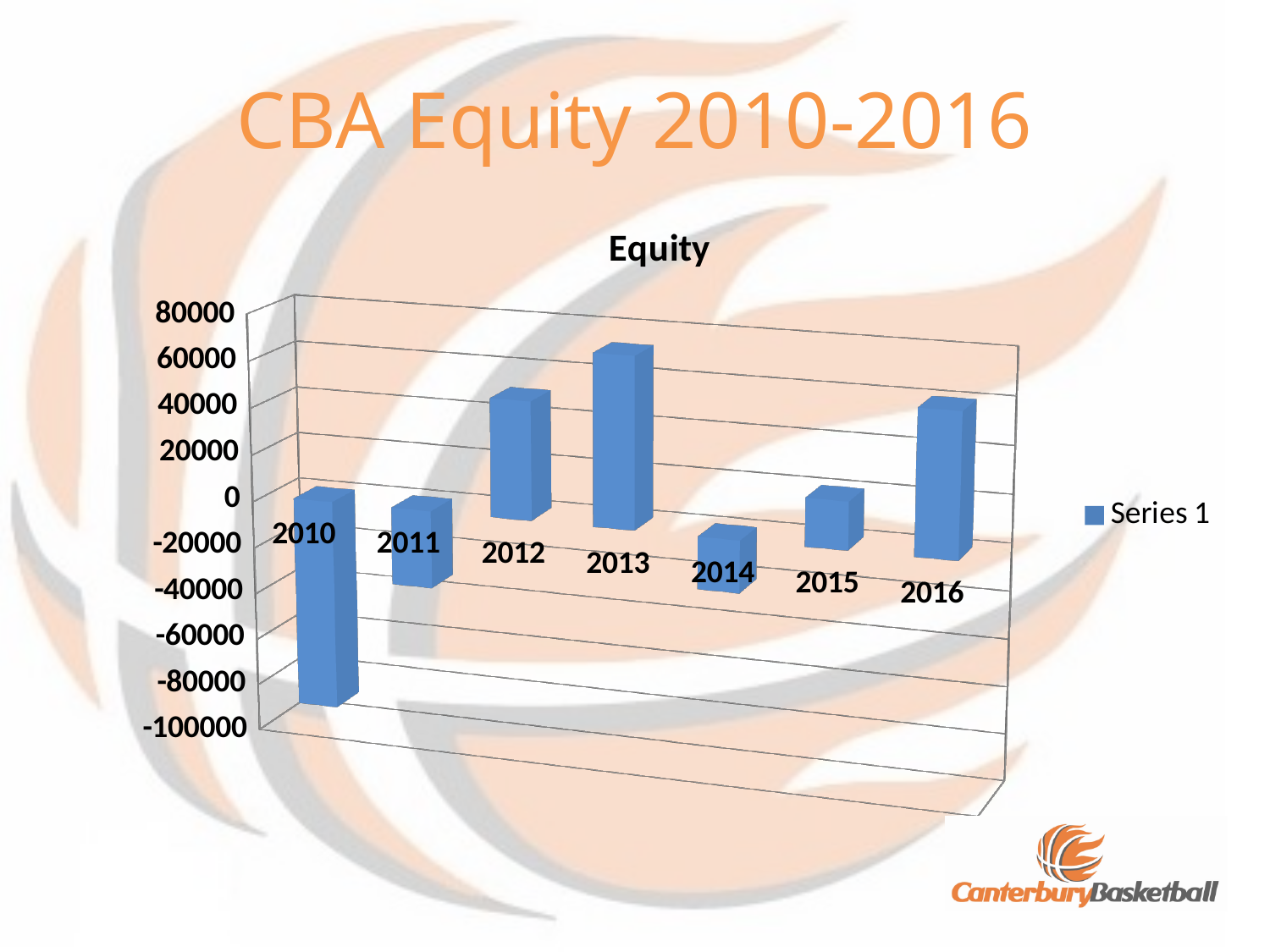
What is the title of the chart? Equity Is the value for 2013 greater or less than 40000? greater What is the name of the series shown in the legend? Series 1 What kind of chart is shown on the slide? bar chart Which year has the larger equity value, 2010 or 2011? 2011 How many series does the legend list? 1 Do the equity values rise or fall from 2010 to 2013? rise Which year has the lowest equity value? 2010 Which year has the larger equity value, 2012 or 2013? 2013 How many years are plotted on the x axis of the chart? 7 Which year has the highest equity value? 2013 Is the value for 2010 greater or less than -60000? less